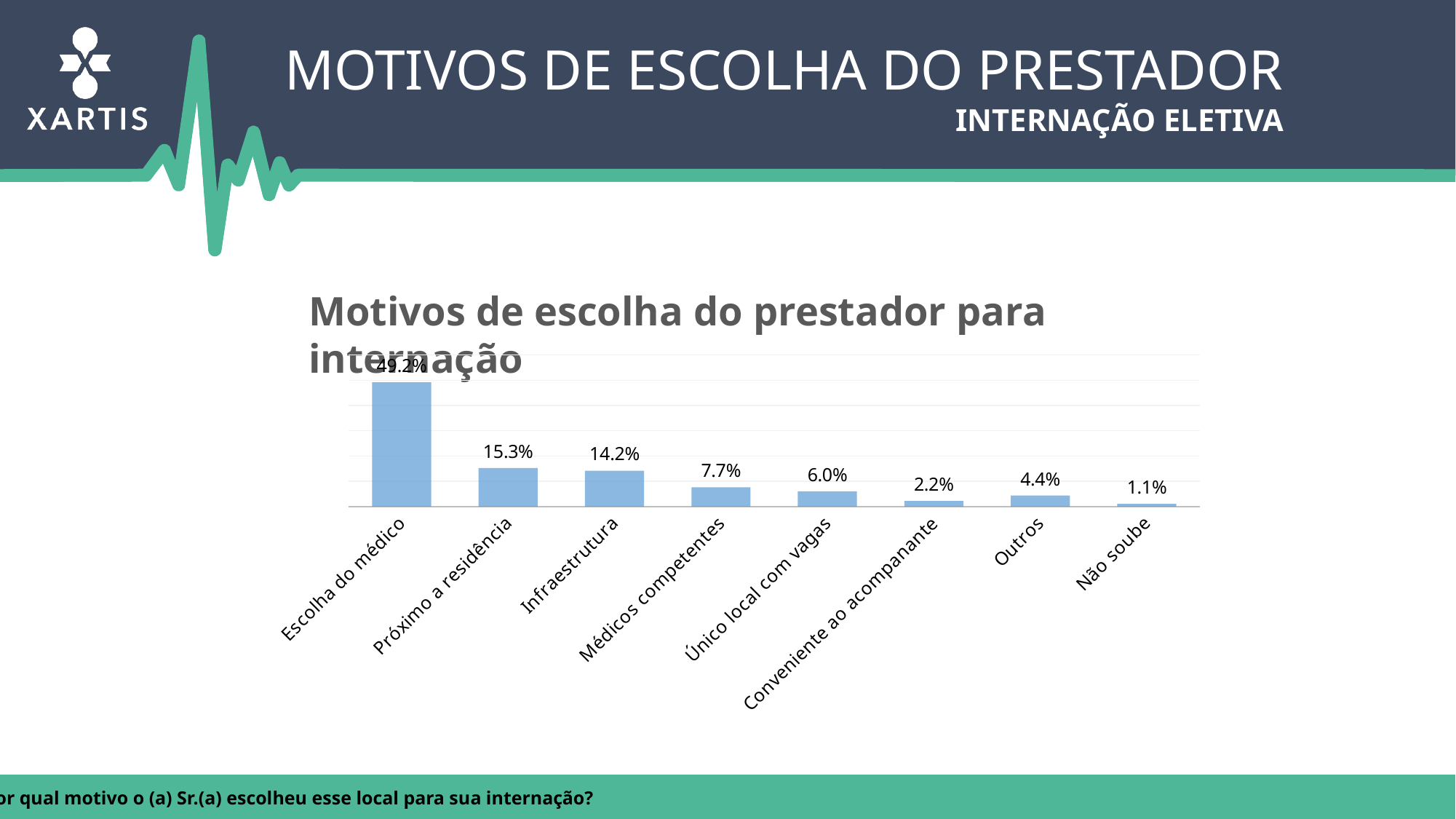
What is the value for Único local com vagas? 6.0% Which category has the highest value? Escolha do médico What is the value for Próximo a residência? 15.3% Which category has the lowest value? Não soube What is the title of the chart? Motivos de escolha do prestador para internação What is the value for Infraestrutura? 14.2% What is the difference between the values for Próximo a residência and Infraestrutura? 1.1% What is the value for Outros? 4.4% Which is larger, the value for Outros or the value for Conveniente ao acompanhante? Outros How many categories are shown in the chart? 8 What is the value for Médicos competentes? 7.7% What type of chart is shown on the slide? bar chart